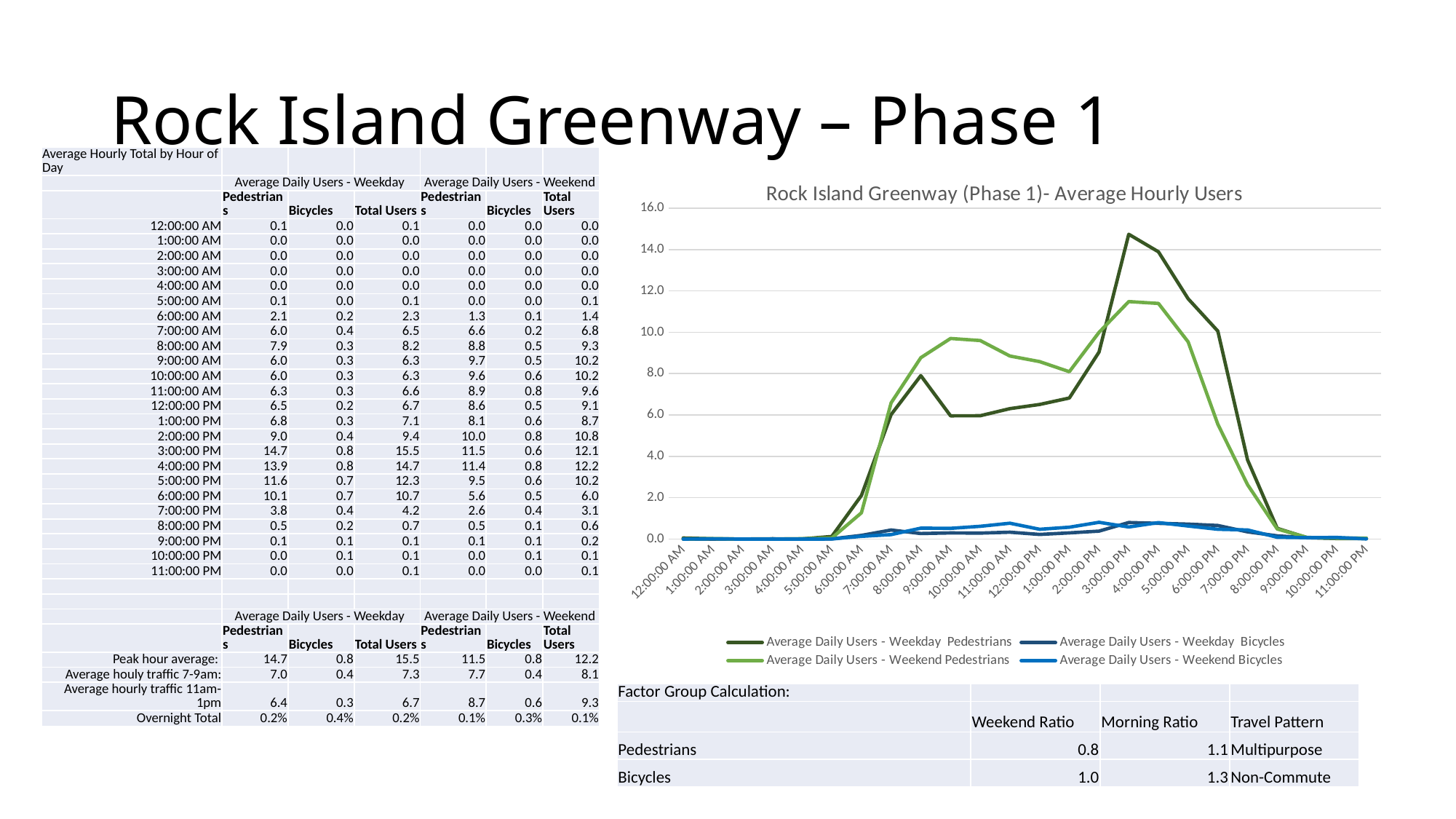
Do the Weekday Pedestrians values rise or fall from 3:00:00 PM to 8:00:00 PM? fall Is the value for Weekday Pedestrians at 6:00:00 PM greater or less than 8.0? greater At which hour does the Average Daily Users - Weekday Pedestrians line reach its highest value? 3:00:00 PM How many hourly points are plotted along the x axis of the chart? 24 At 4:00:00 PM, which is larger: Weekday Pedestrians or Weekend Pedestrians? Weekday Pedestrians Is the value for Weekend Pedestrians at 9:00:00 AM greater or less than 8.0? greater Is the value for Weekday Pedestrians at 3:00:00 PM greater or less than 14.0? greater At 9:00:00 AM, which is larger: Weekday Pedestrians or Weekend Pedestrians? Weekend Pedestrians According to the table, what is the peak hour average for Weekday Pedestrians? 14.7 What is the title of the chart? Rock Island Greenway (Phase 1)- Average Hourly Users What kind of chart is shown on the slide? line chart How many series does the chart's legend list? 4